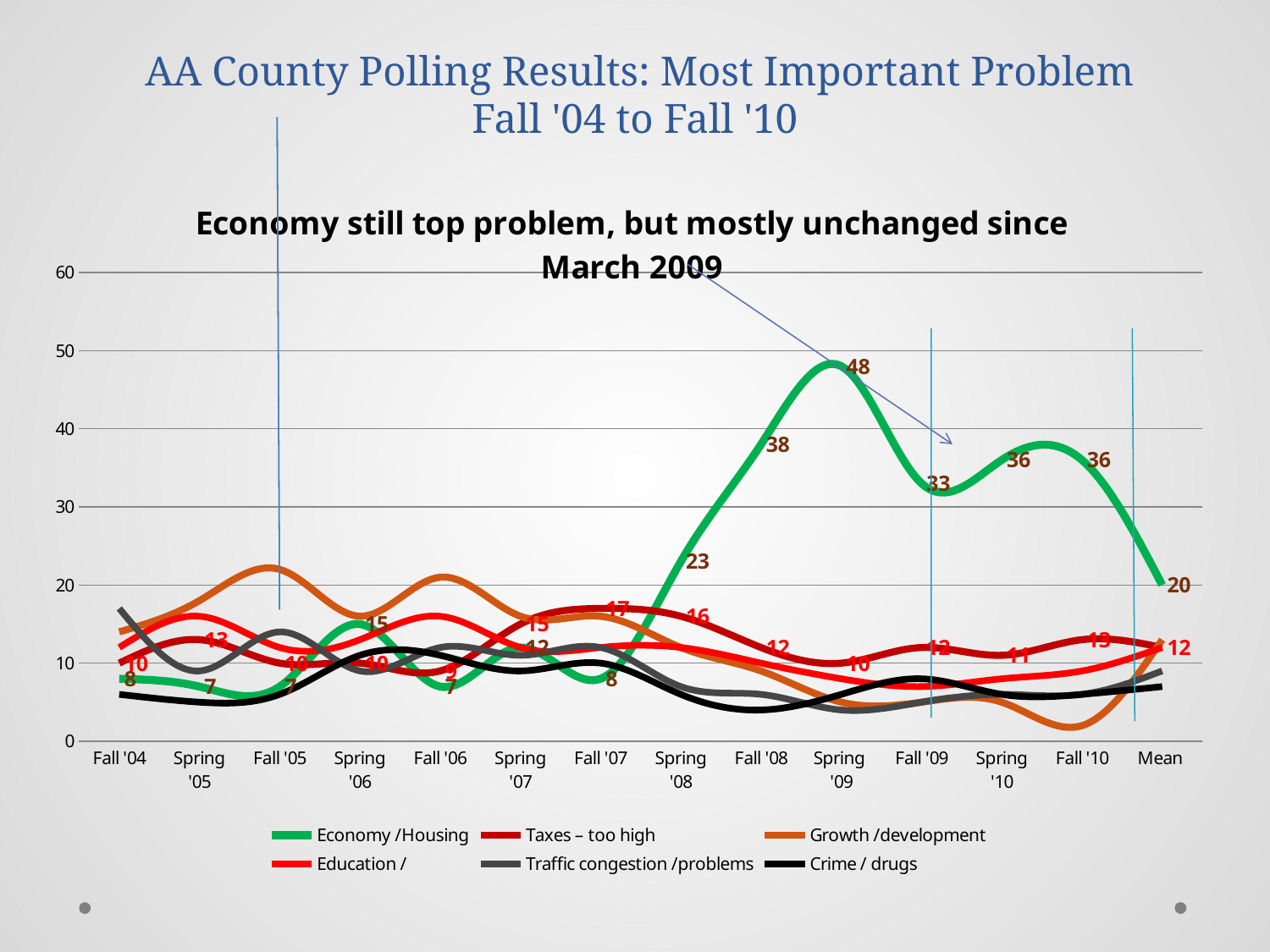
What is the value for Economy /Housing at Spring '09? 48 What is the value for Economy /Housing at Fall '08? 38 Does the Economy /Housing series rise or fall from Spring '08 to Spring '09? rise Which is larger for Economy /Housing: the value at Fall '08 or at Fall '09? Fall '08 What kind of chart is shown on the slide? line chart At which point does the Economy /Housing series reach its highest value? Spring '09 Is the value for Growth /development at Fall '10 greater or less than 10? less What is the Mean value for Economy /Housing? 20 How many categories are shown along the x axis? 14 What is the title of the chart? Economy still top problem, but mostly unchanged since March 2009 How many series does the legend list? 6 What is the difference between the Economy /Housing values at Spring '09 and Fall '09? 15